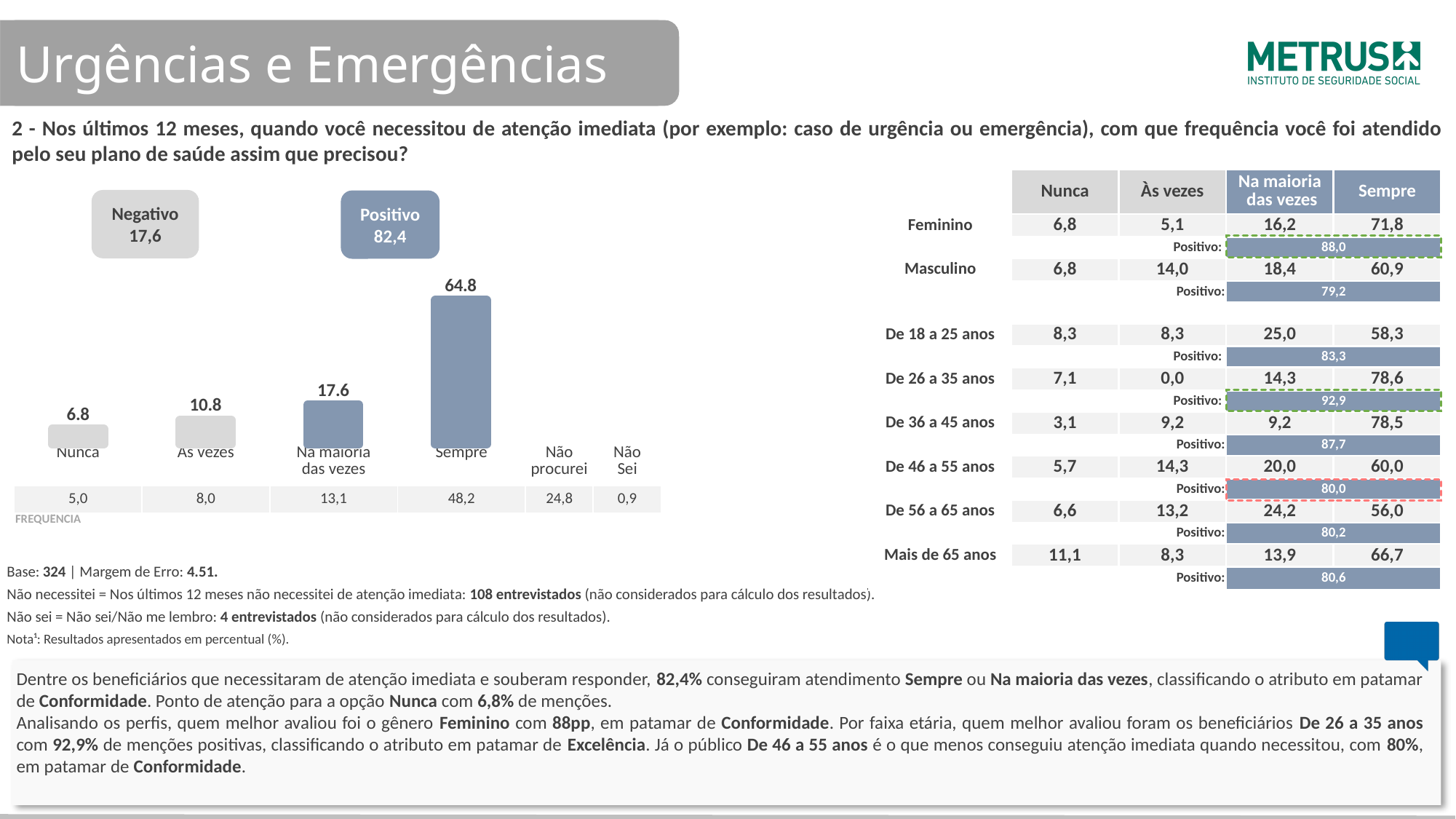
What is the value of the bar for Nunca? 6.8 What type of chart is shown on the left of the slide? Bar chart What is the value of the bar for Sempre? 64.8 Which is larger, the value for Na maioria das vezes or the value for Às vezes? Na maioria das vezes What is the difference between the values for Às vezes and Nunca? 4.0 What is the difference between the values for Sempre and Na maioria das vezes? 47.2 Which category has the lowest bar in the chart? Nunca What is the value of the bar for Na maioria das vezes? 17.6 What value is shown in the Positivo box above the chart? 82,4 What is the value of the bar for Às vezes? 10.8 How many bars are plotted in the chart? 4 Which category has the highest bar in the chart? Sempre